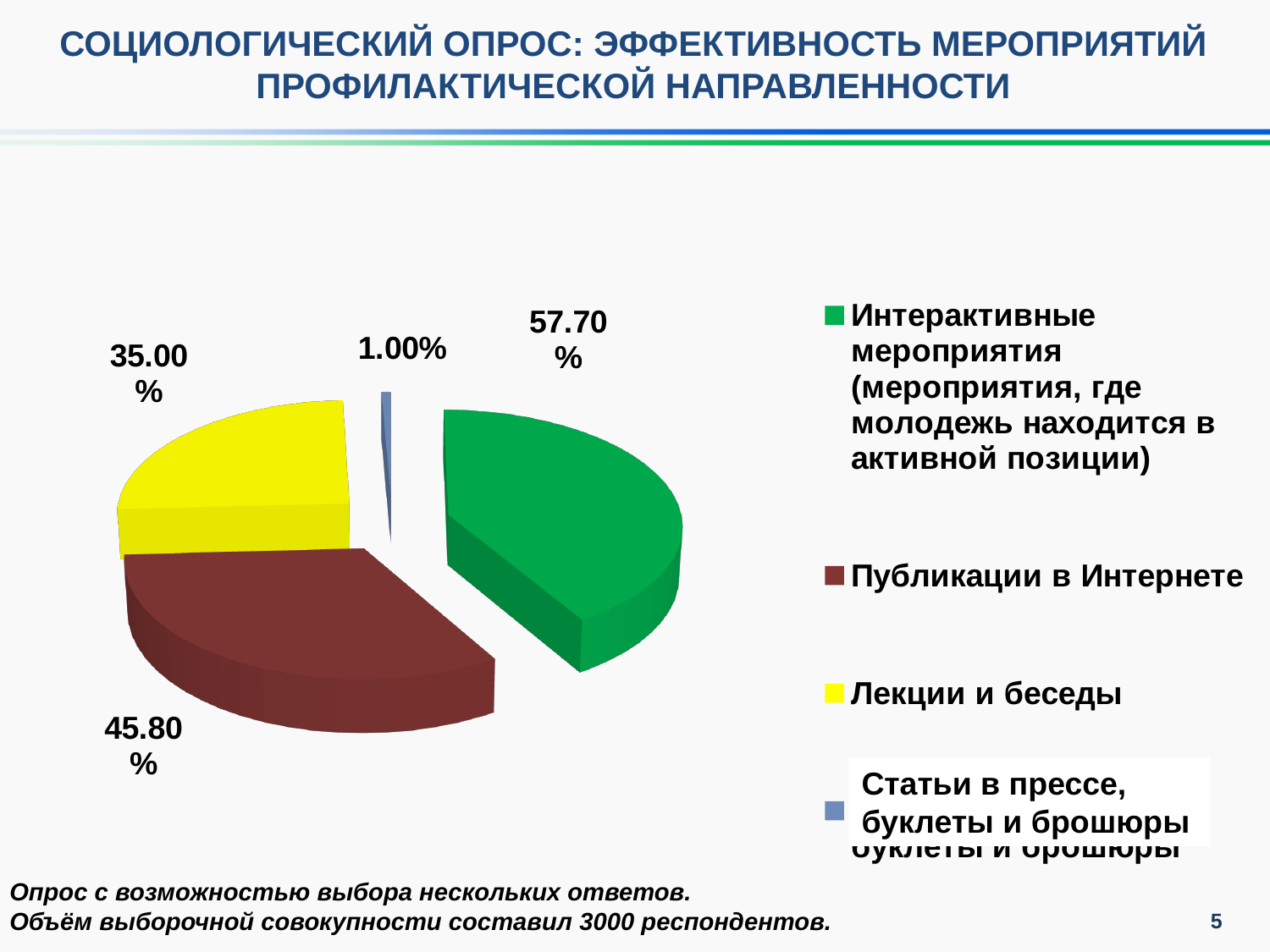
What is the value for Публикации в Интернете? 45.80% What is the value for Лекции и беседы? 35.00% What is the value for Статьи в прессе, буклеты и брошюры? 1.00% What colour is the slice for Лекции и беседы? Yellow What is the value for Интерактивные мероприятия? 57.70% Which category has the largest slice of the pie? Интерактивные мероприятия Which category has the smallest slice of the pie? Статьи в прессе, буклеты и брошюры Which is larger, the value for Лекции и беседы or the value for Публикации в Интернете? Публикации в Интернете What is the difference between the values for Интерактивные мероприятия and Публикации в Интернете? 11.90% What kind of chart is shown on the slide? Pie chart What is the difference between the values for Публикации в Интернете and Лекции и беседы? 10.80% How many categories does the pie chart have? 4